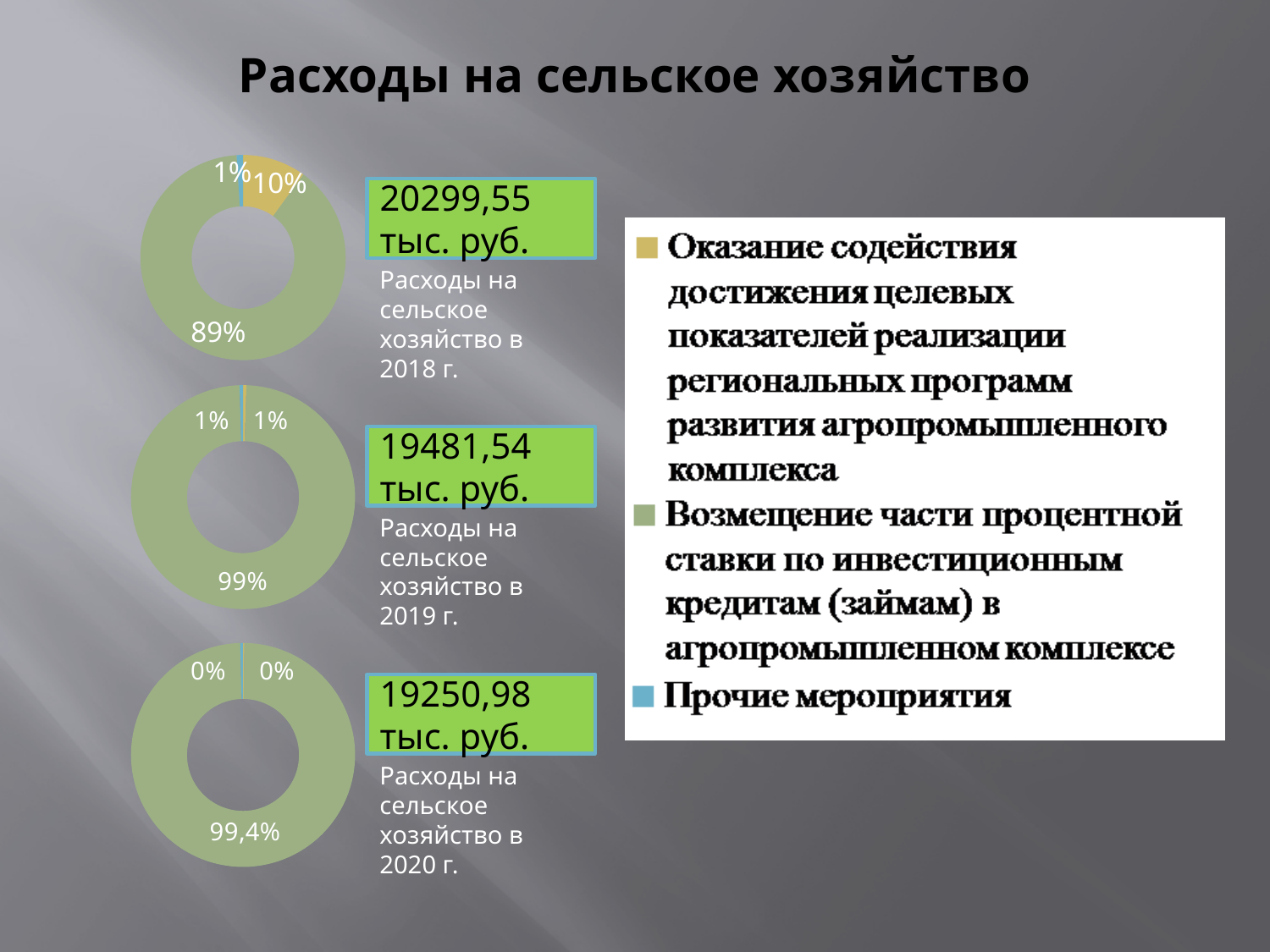
Which year's chart shows the larger total expenditure: 2019 (19481,54 тыс. руб.) or 2020 (19250,98 тыс. руб.)? 2019 In the 2018 chart (Расходы на сельское хозяйство в 2018 г.), what share is labelled for the green slice (Возмещение части процентной ставки по инвестиционным кредитам)? 89% In the 2018 chart, what is the difference in percentage points between the green slice (89%) and the yellow slice (10%)? 79 percentage points What is the title of the slide containing the donut charts? Расходы на сельское хозяйство What total expenditure amount is shown next to the 2018 chart? 20299,55 тыс. руб. How many donut charts are shown on the slide? 3 In the 2020 chart (Расходы на сельское хозяйство в 2020 г.), what share is labelled for Возмещение части процентной ставки по инвестиционным кредитам? 99,4% In the 2019 chart (Расходы на сельское хозяйство в 2019 г.), what share is labelled for the largest slice? 99% How many series does the shared legend list for the donut charts? 3 What kind of chart is used to show the agricultural expenditure structure for each year? Donut (pie) chart In the 2018 chart, what share is labelled for the yellow slice (Оказание содействия достижения целевых показателей)? 10% In the 2018 chart, what share is labelled for Прочие мероприятия? 1%